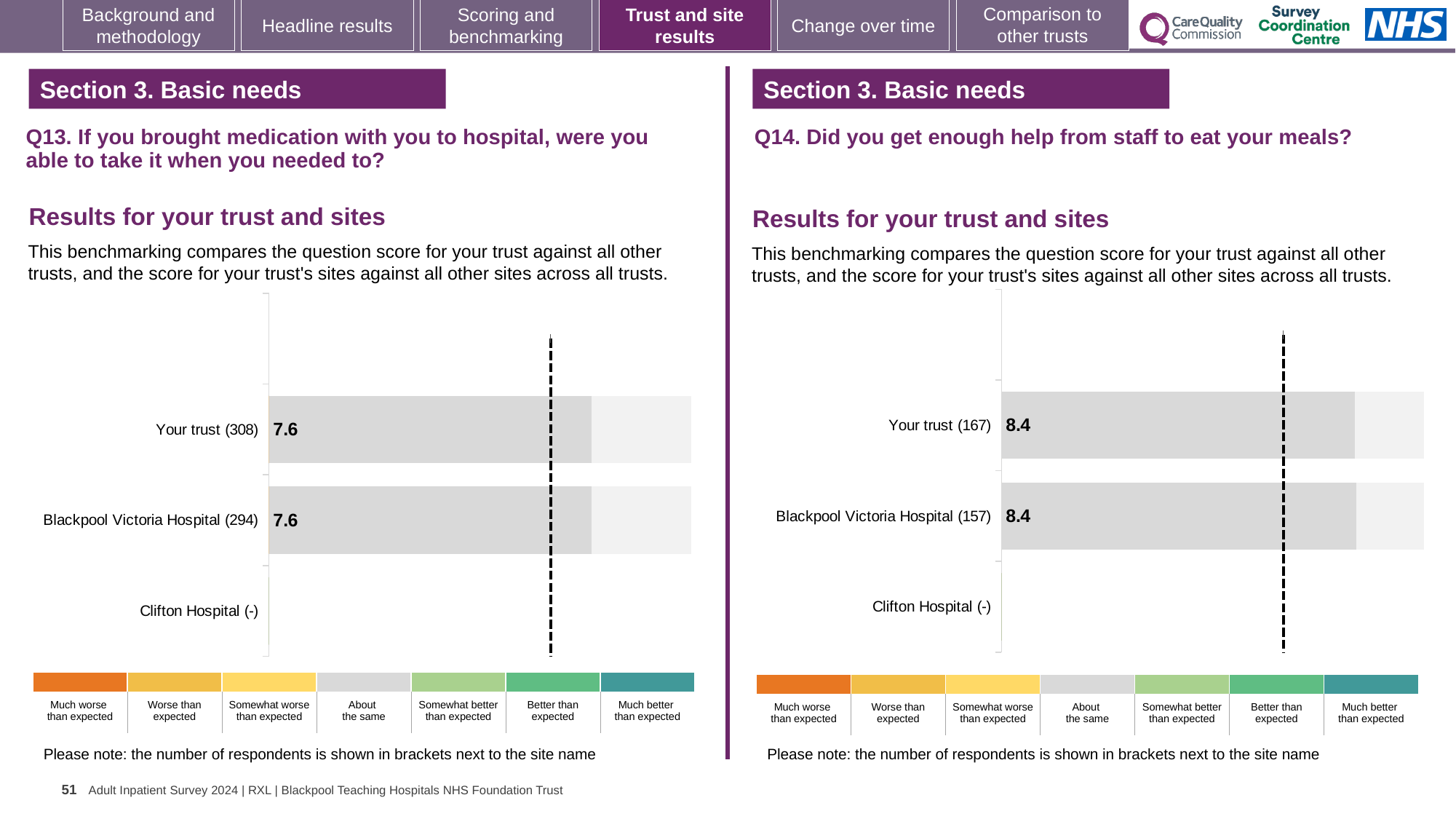
On the Q13 chart (left), what is the score for Your trust? 7.6 On the Q13 chart (left), what is the score for Blackpool Victoria Hospital? 7.6 On the Q14 chart (right), how many respondents are shown in brackets for Blackpool Victoria Hospital? 157 On the Q14 chart (right), how many site/trust categories are listed on the vertical axis? 3 On the Q13 chart (left), what is the difference between the score for Your trust and the score for Blackpool Victoria Hospital? 0 On the Q13 chart (left), which category has no bar plotted? Clifton Hospital (-) What kind of chart is the Q13 chart (left)? Bar chart On the Q14 chart (right), what is the score for Your trust? 8.4 On the Q14 chart (right), how many categories does the colour key below the chart list? 7 On the Q13 chart (left), how many respondents are shown in brackets for Your trust? 308 On the Q14 chart (right), what is the score for Blackpool Victoria Hospital? 8.4 Is the score for Your trust on the Q14 chart (right) larger or smaller than the score for Your trust on the Q13 chart (left)? Larger